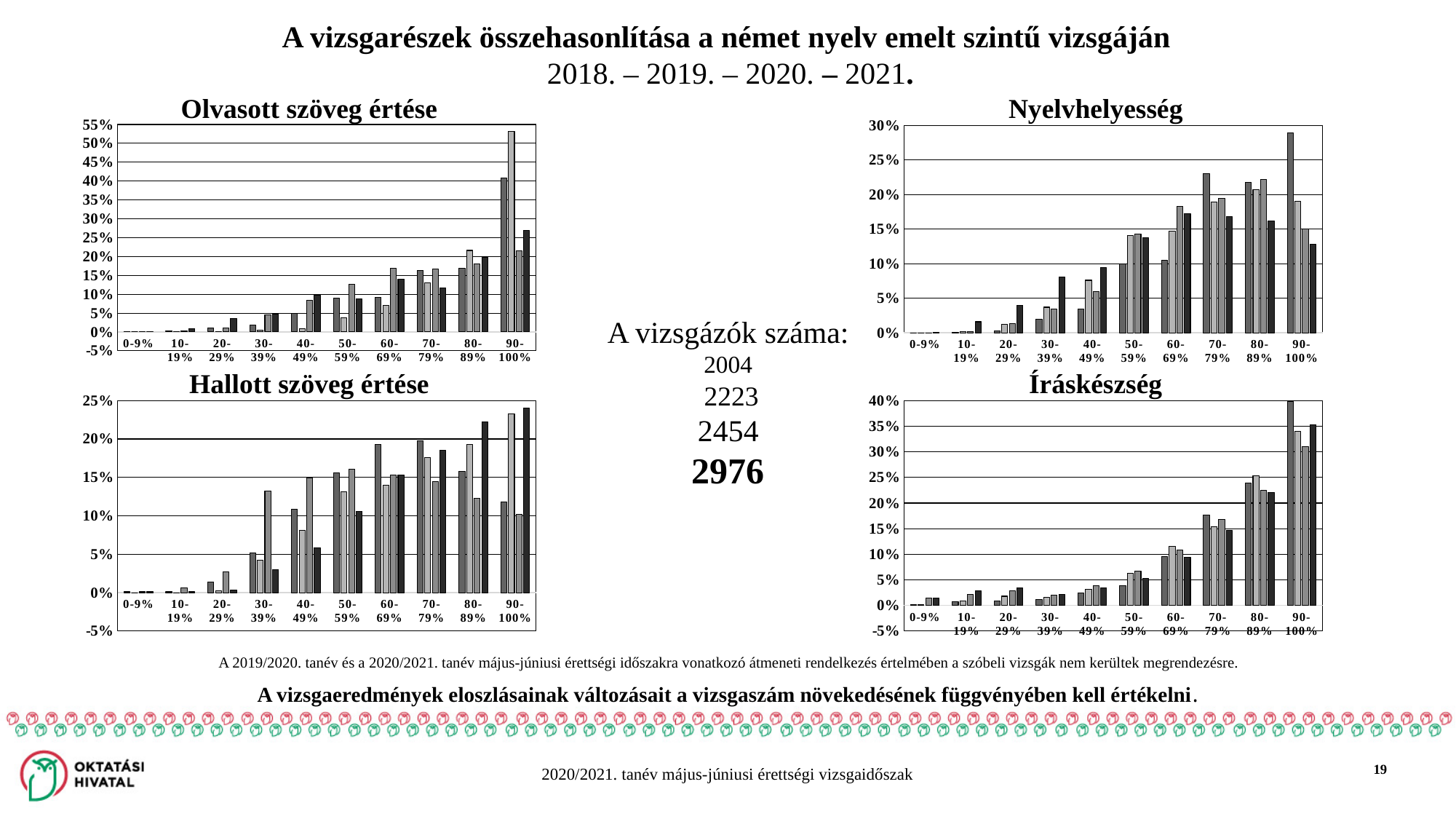
In the "Íráskészség" chart, do the bar heights generally rise or fall moving from the 0-9% category to the 90-100% category? rise In the "Olvasott szöveg értése" chart, is the tallest bar in the 90-100% category greater or less than 40%? greater In the "Nyelvhelyesség" chart, is the tallest bar in the 90-100% category greater or less than 25%? greater What kind of chart is the "Olvasott szöveg értése" chart? bar chart In the "Íráskészség" chart, which score-range category contains the tallest bar? 90-100% In the "Nyelvhelyesség" chart, are the bars for the 0-9% category greater or less than 5%? less In the "Olvasott szöveg értése" chart, which score-range category contains the tallest bar? 90-100% How many charts are shown on the slide? 4 What is the title of the chart in the bottom-left of the slide? Hallott szöveg értése How many score-range categories are shown on the x axis of the "Nyelvhelyesség" chart? 10